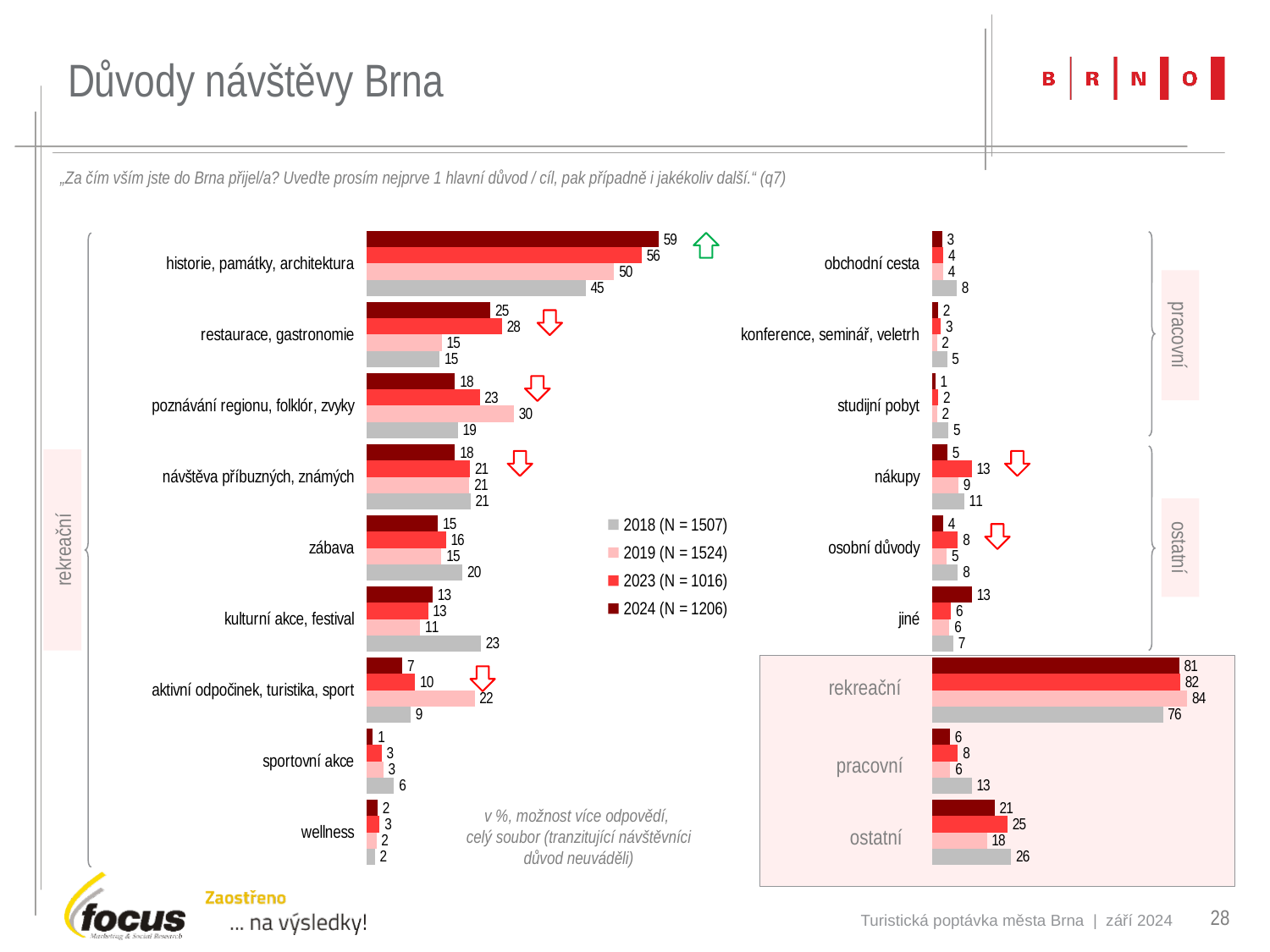
In the bottom right chart, what is the 2019 value for "rekreační"? 84 In the left chart, what is the 2024 value for "historie, památky, architektura"? 59 In the upper right chart, what is the 2023 value for "nákupy"? 13 What type of chart is used on this slide? bar chart In the left chart, what is the difference between the 2024 and 2018 values for "historie, památky, architektura"? 14 In the left chart, which category has the lowest 2024 value? sportovní akce In the left chart, which category has the highest 2024 value? historie, památky, architektura In the left chart, what is the 2019 value for "aktivní odpočinek, turistika, sport"? 22 How many categories are shown in the left chart? 9 How many series does the legend list? 4 In the left chart, which is larger for "kulturní akce, festival": the 2018 value or the 2024 value? 2018 In the upper right chart, which category has the highest 2024 value? jiné